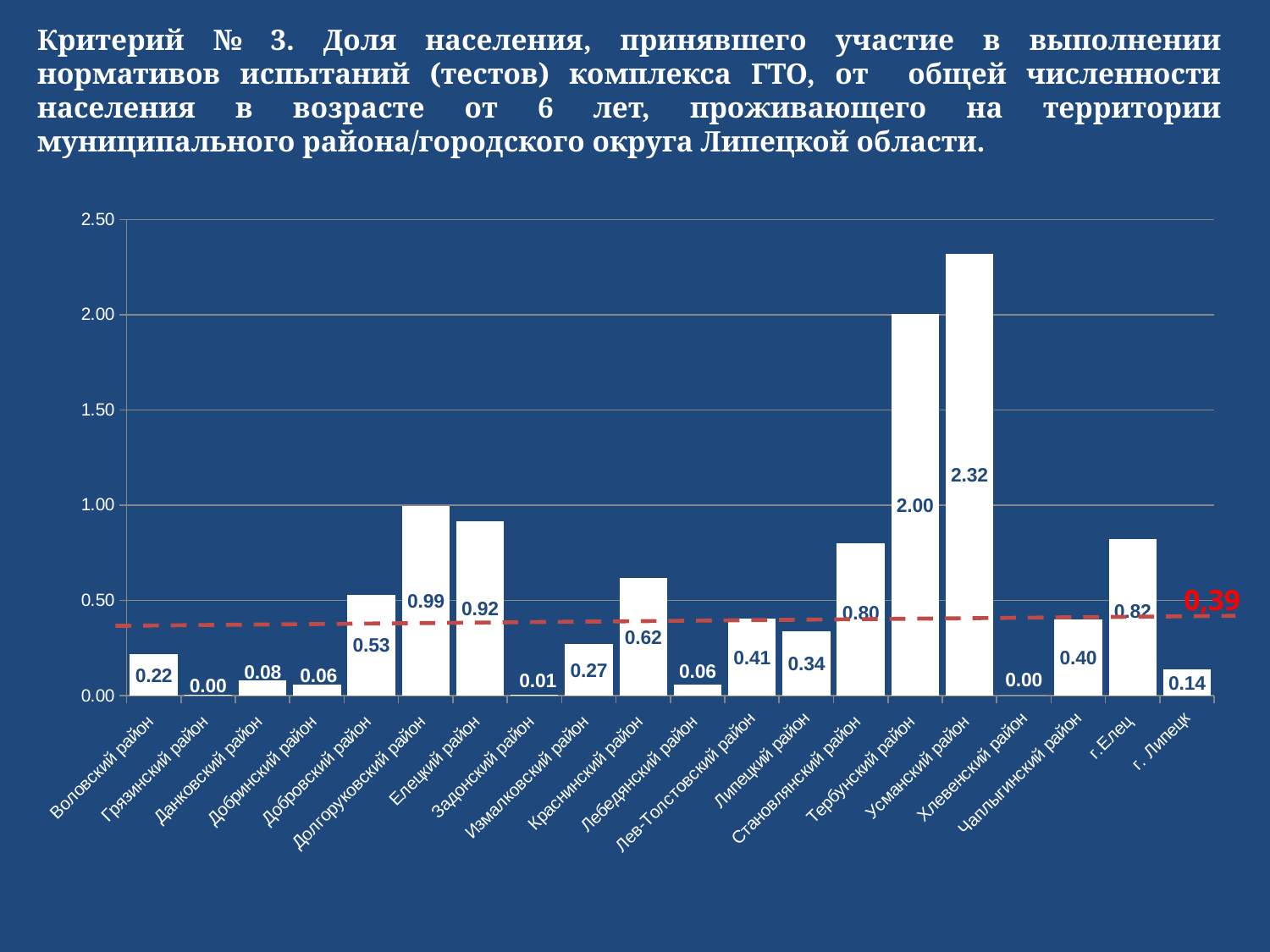
What is the value for Долгоруковский район? 0.99 Which is larger, the value for Долгоруковский район or Елецкий район? Долгоруковский район Is the value for Становлянский район greater or less than 0.50? greater What is the value for Чаплыгинский район? 0.40 What kind of chart is shown on the slide? bar chart What is the difference between the values for Усманский район and Тербунский район? 0.32 What is the value for Усманский район? 2.32 What value is labelled on the red dashed horizontal line? 0,39 Which category has the highest value? Усманский район How many categories are shown on the x axis? 20 What is the difference between the values for г.Елец and Становлянский район? 0.02 What is the value for г. Липецк? 0.14